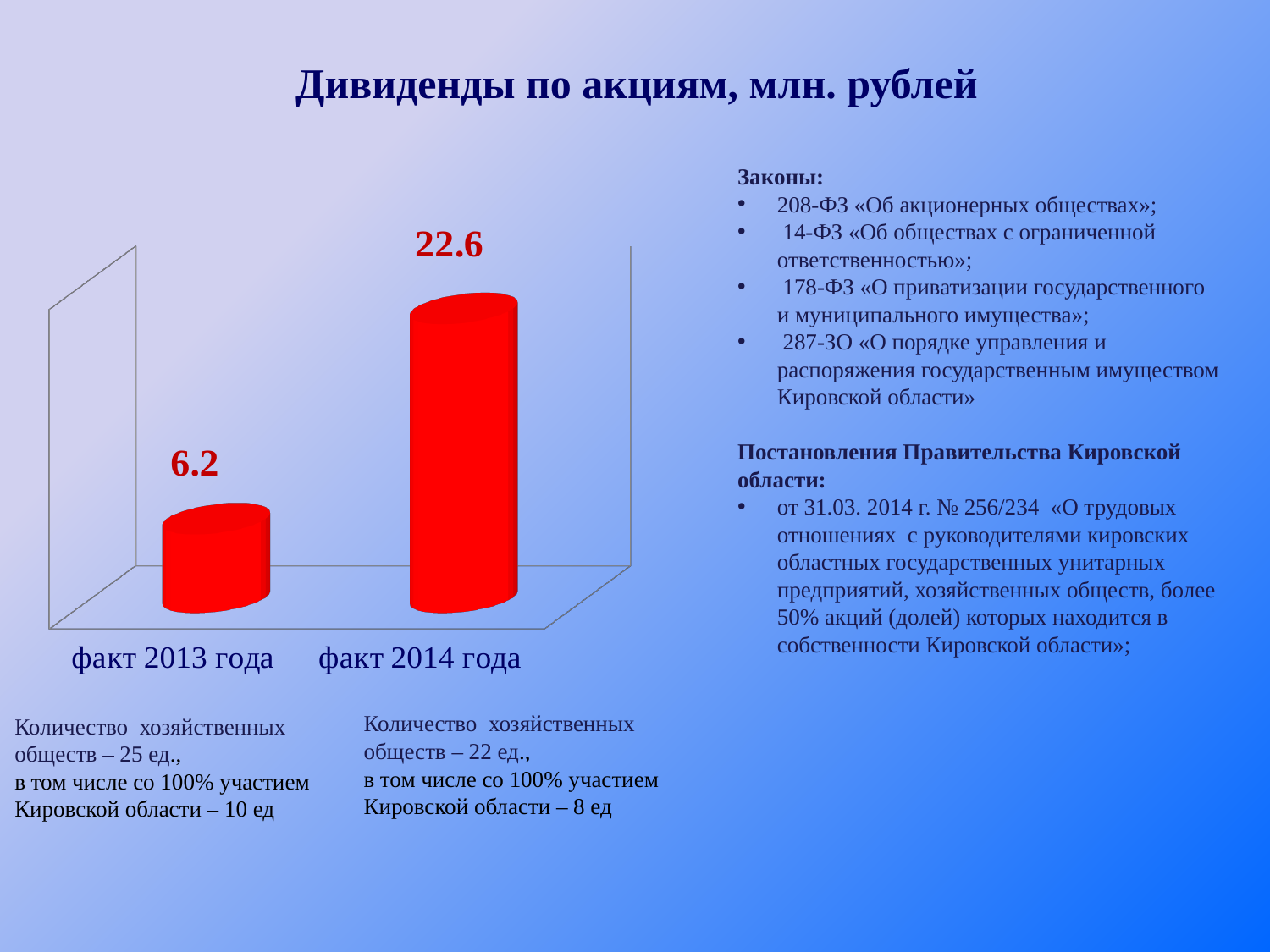
How many categories are shown in the chart? 2 What is the value for факт 2014 года? 22.6 What is the title of the chart? Дивиденды по акциям, млн. рублей What kind of chart is shown on the slide? bar chart Which category has the lowest value? факт 2013 года What is the difference between the values for факт 2014 года and факт 2013 года? 16.4 What colour are the bars in the chart? red What is the value for факт 2013 года? 6.2 Which is larger, the value for факт 2013 года or факт 2014 года? факт 2014 года Which category has the highest value? факт 2014 года Do the values rise or fall from факт 2013 года to факт 2014 года? rise